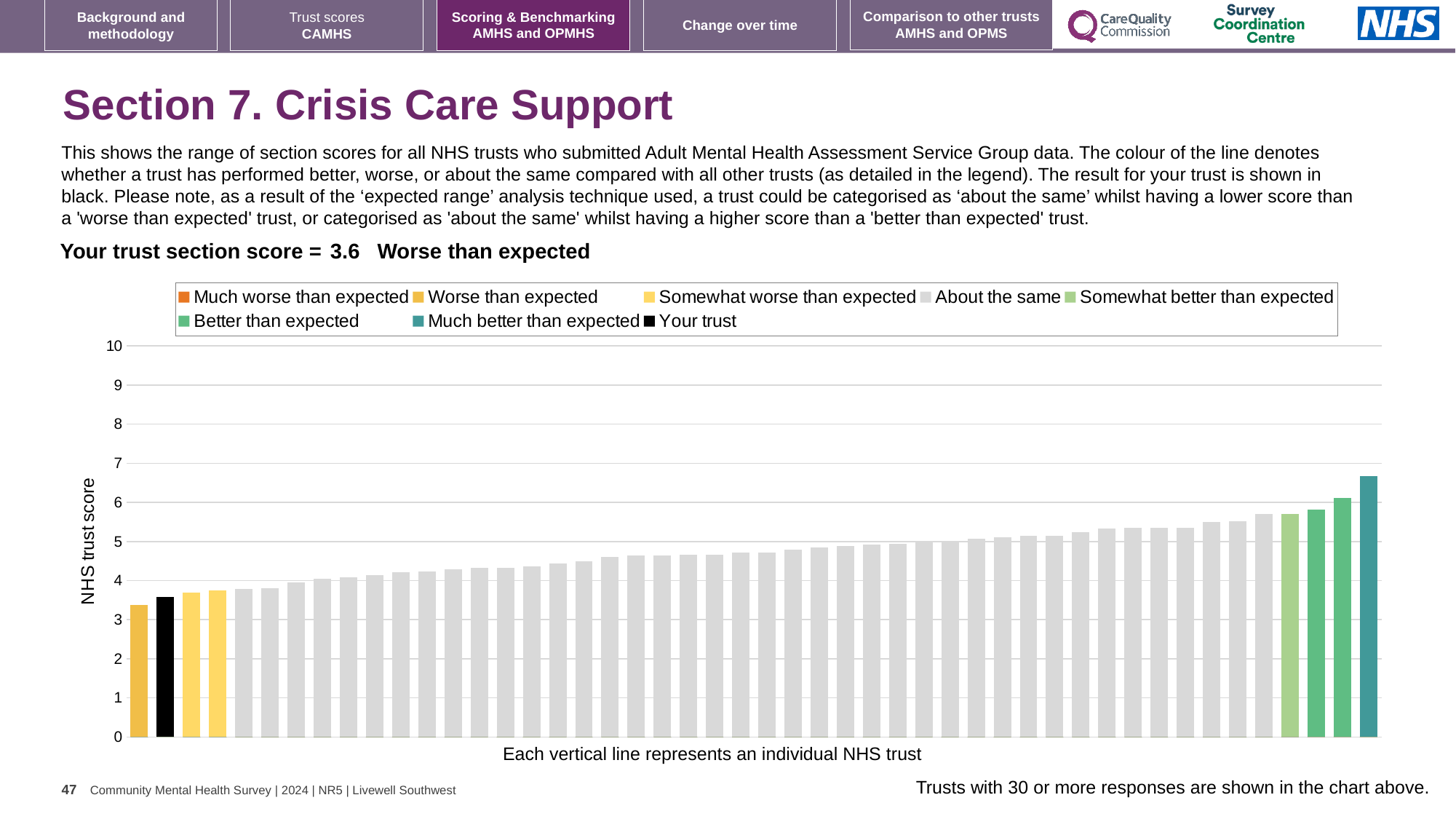
Which is taller: the black bar for your trust or the leftmost bar in the chart? The black bar for your trust How is your trust's section score categorised on the slide? Worse than expected What colour is used in the chart to show your trust? Black How many entries does the chart legend list? 8 Is the value of the shortest bar in the chart greater or less than 4? less Is the value for your trust (the black bar) greater or less than 4? less What kind of chart is shown on the slide? Bar chart What is the highest value shown on the vertical axis of the chart? 10 What is the label on the vertical axis of the chart? NHS trust score Is the value of the tallest bar in the chart greater or less than 6? greater Do the bar values rise or fall from left to right along the x axis? Rise What is the section score for your trust shown on the slide? 3.6